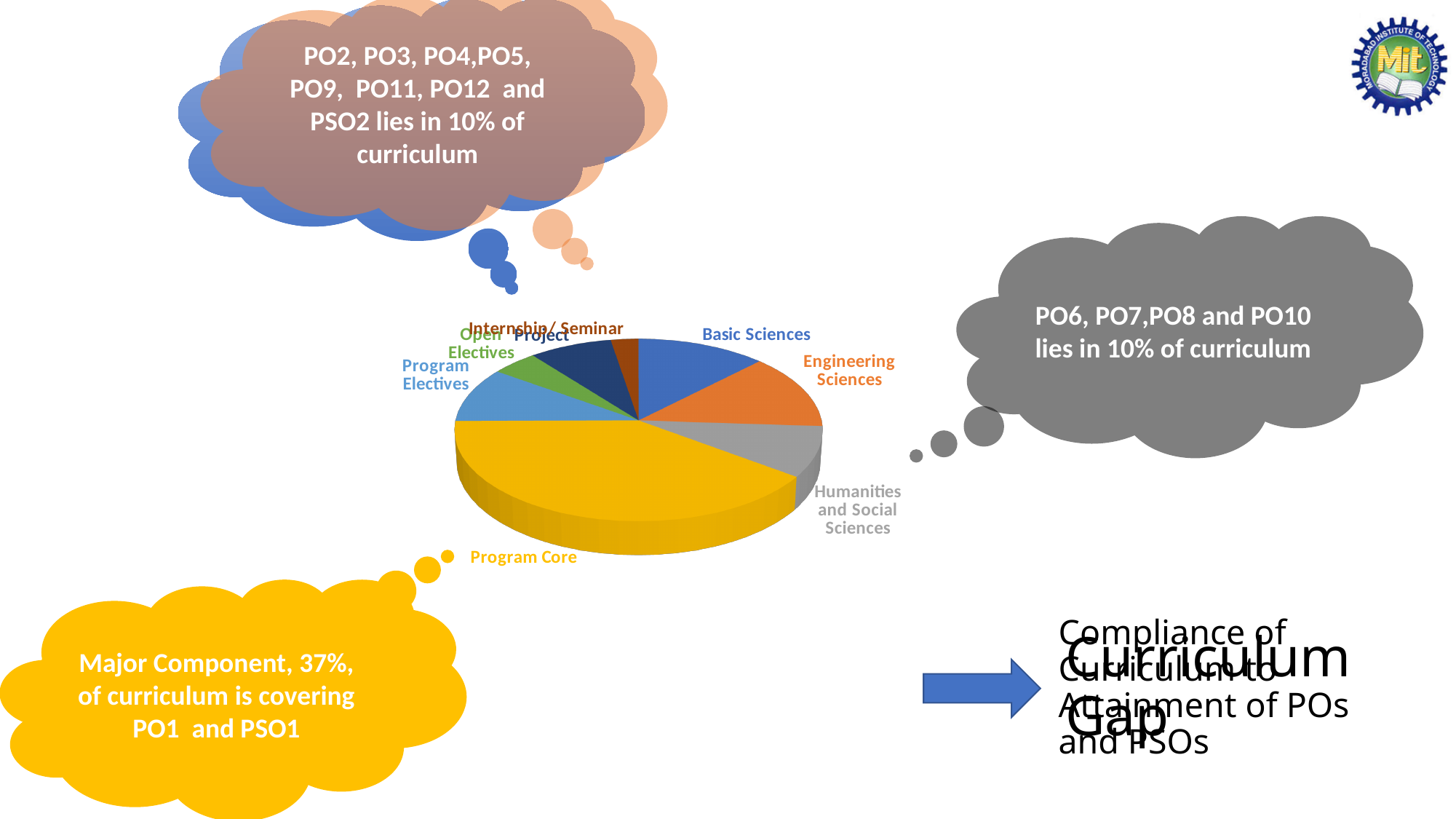
Which slice is larger, Humanities and Social Sciences or Open Electives? Humanities and Social Sciences What colour is the Program Core slice of the pie chart? yellow Which category has the largest slice in the pie chart? Program Core Which slice is larger, Program Electives or Internship/ Seminar? Program Electives What colour is the Engineering Sciences slice of the pie chart? orange What kind of chart is shown on the slide? pie chart Which slice is larger, Engineering Sciences or Internship/ Seminar? Engineering Sciences How many categories (slices) does the pie chart have? 8